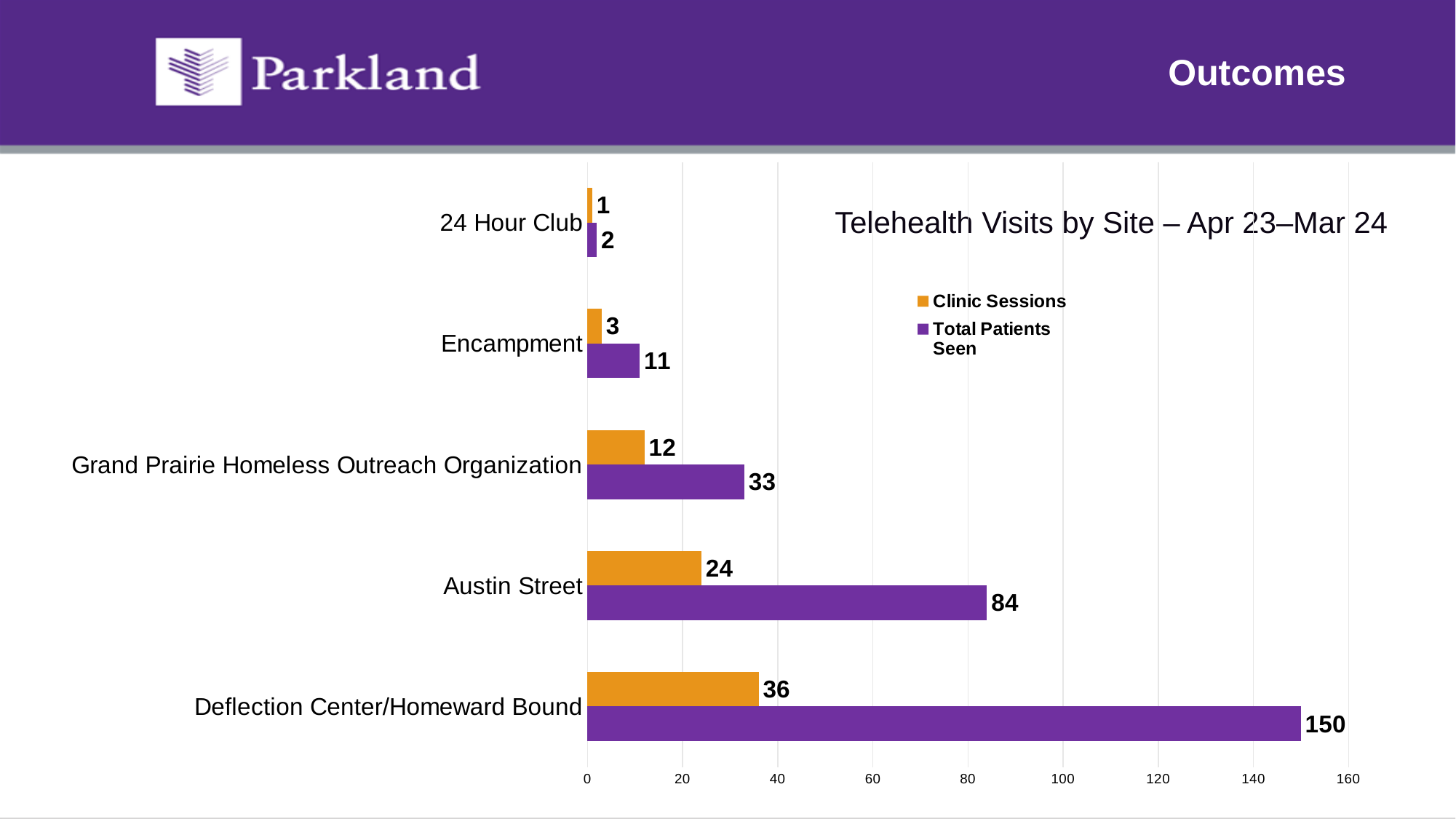
How many series does the legend list? 2 What kind of chart is shown on the slide? Bar chart How many Clinic Sessions are shown for Grand Prairie Homeless Outreach Organization? 12 Which site has the lowest number of Clinic Sessions? 24 Hour Club How many sites are shown on the chart? 5 What is the Clinic Sessions value for 24 Hour Club? 1 What is the title of the chart? Telehealth Visits by Site – Apr 23–Mar 24 Which is larger: Total Patients Seen for Encampment or Clinic Sessions for Austin Street? Clinic Sessions for Austin Street Is the Total Patients Seen value for Deflection Center/Homeward Bound greater or less than 140? greater What is the difference between Total Patients Seen and Clinic Sessions for Deflection Center/Homeward Bound? 114 Which site has the highest Total Patients Seen? Deflection Center/Homeward Bound What is the Total Patients Seen value for Austin Street? 84